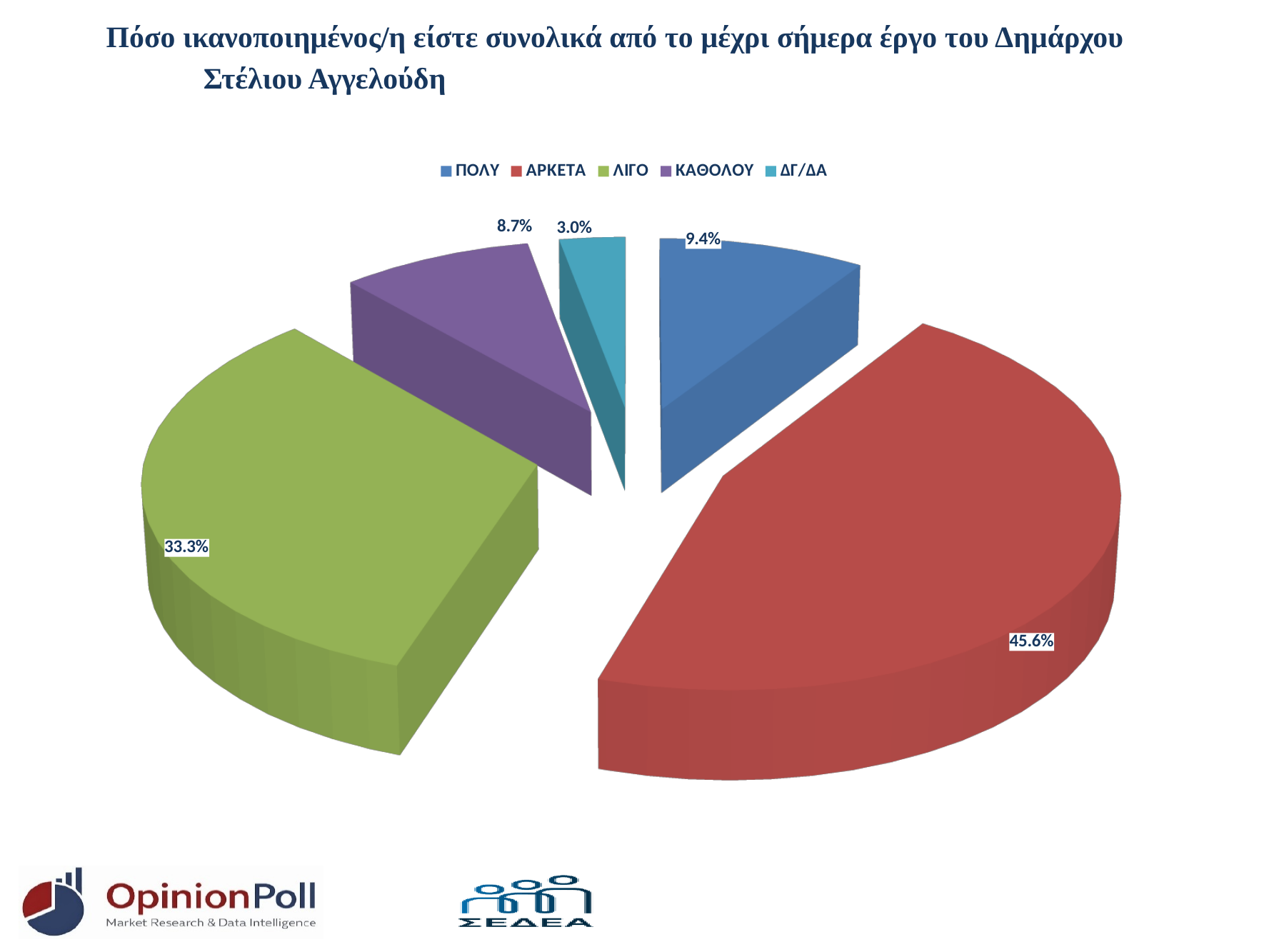
What is the difference in percentage points between ΑΡΚΕΤΑ and ΛΙΓΟ? 12.3 Which response category has the largest share of the pie? ΑΡΚΕΤΑ What percentage of respondents answered ΠΟΛΥ? 9.4% Which colour represents ΛΙΓΟ in the pie chart? green What percentage of respondents answered ΛΙΓΟ? 33.3% What percentage of respondents answered ΔΓ/ΔΑ? 3.0% What kind of chart is shown on the slide? pie chart What percentage of respondents answered ΑΡΚΕΤΑ? 45.6% Which response category has the smallest share of the pie? ΔΓ/ΔΑ How many categories does the legend list? 5 What percentage of respondents answered ΚΑΘΟΛΟΥ? 8.7% Which is larger, the share for ΠΟΛΥ or the share for ΚΑΘΟΛΟΥ? ΠΟΛΥ